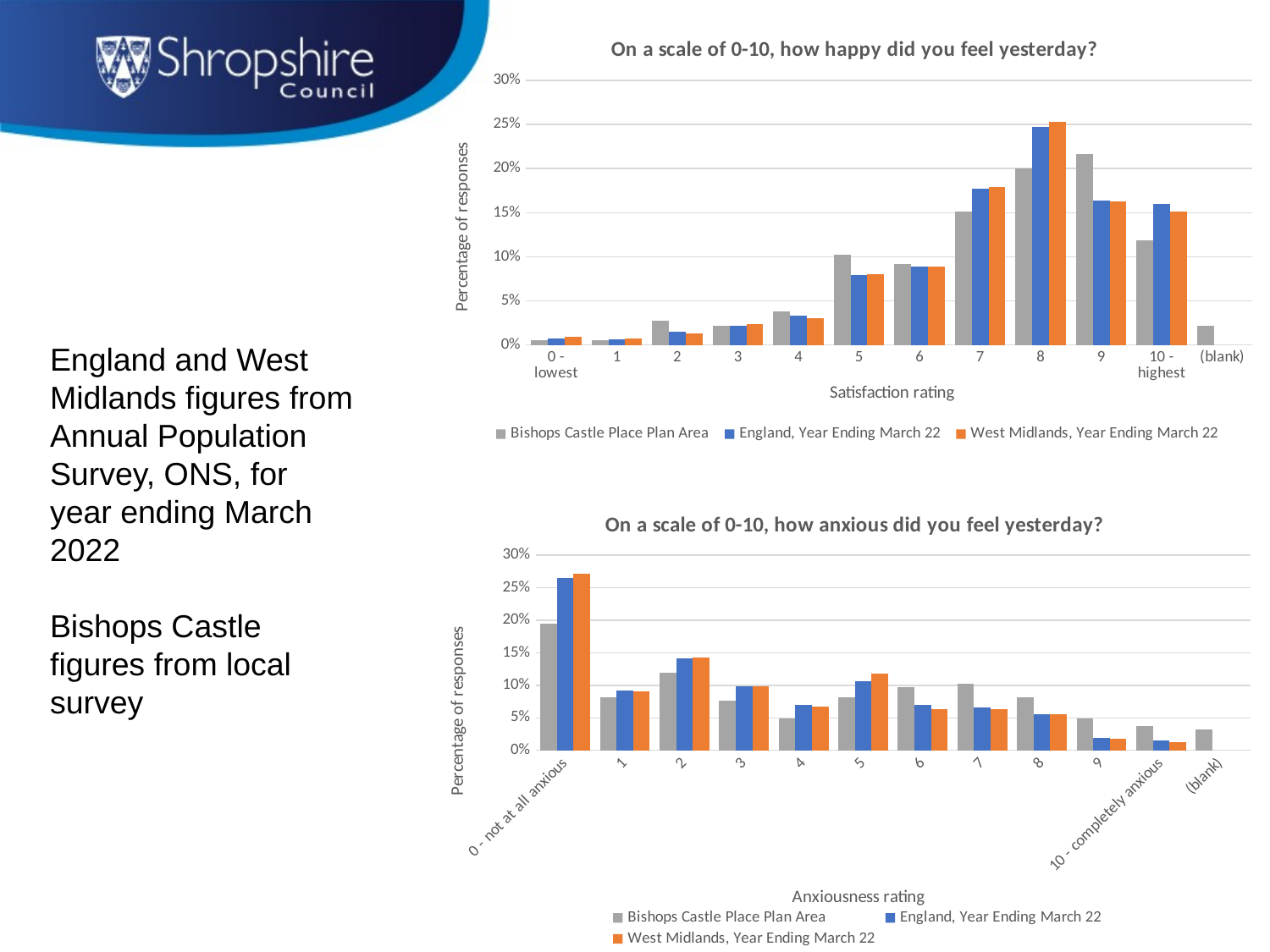
In the 'how happy did you feel yesterday?' chart, is the value for England, Year Ending March 22 at rating 8 greater or less than 20%? greater In the 'how anxious did you feel yesterday?' chart, which is larger at rating 7: Bishops Castle Place Plan Area or England, Year Ending March 22? Bishops Castle Place Plan Area What is the y-axis label of the 'how anxious did you feel yesterday?' chart? Percentage of responses In the 'how anxious did you feel yesterday?' chart, is the value for England, Year Ending March 22 at rating 9 greater or less than 5%? less In the 'how happy did you feel yesterday?' chart, which satisfaction rating has the highest value for England, Year Ending March 22? 8 In the 'how happy did you feel yesterday?' chart, which is larger at rating 9: Bishops Castle Place Plan Area or England, Year Ending March 22? Bishops Castle Place Plan Area In the 'how happy did you feel yesterday?' chart, is the value for Bishops Castle Place Plan Area at '10 - highest' greater or less than 15%? less How many series does the legend of the 'how happy did you feel yesterday?' chart list? 3 In the 'how anxious did you feel yesterday?' chart, which anxiousness rating has the highest value for West Midlands, Year Ending March 22? 0 - not at all anxious How many categories are shown on the x axis of the 'how happy did you feel yesterday?' chart? 12 What kind of chart is the 'On a scale of 0-10, how happy did you feel yesterday?' chart? bar chart